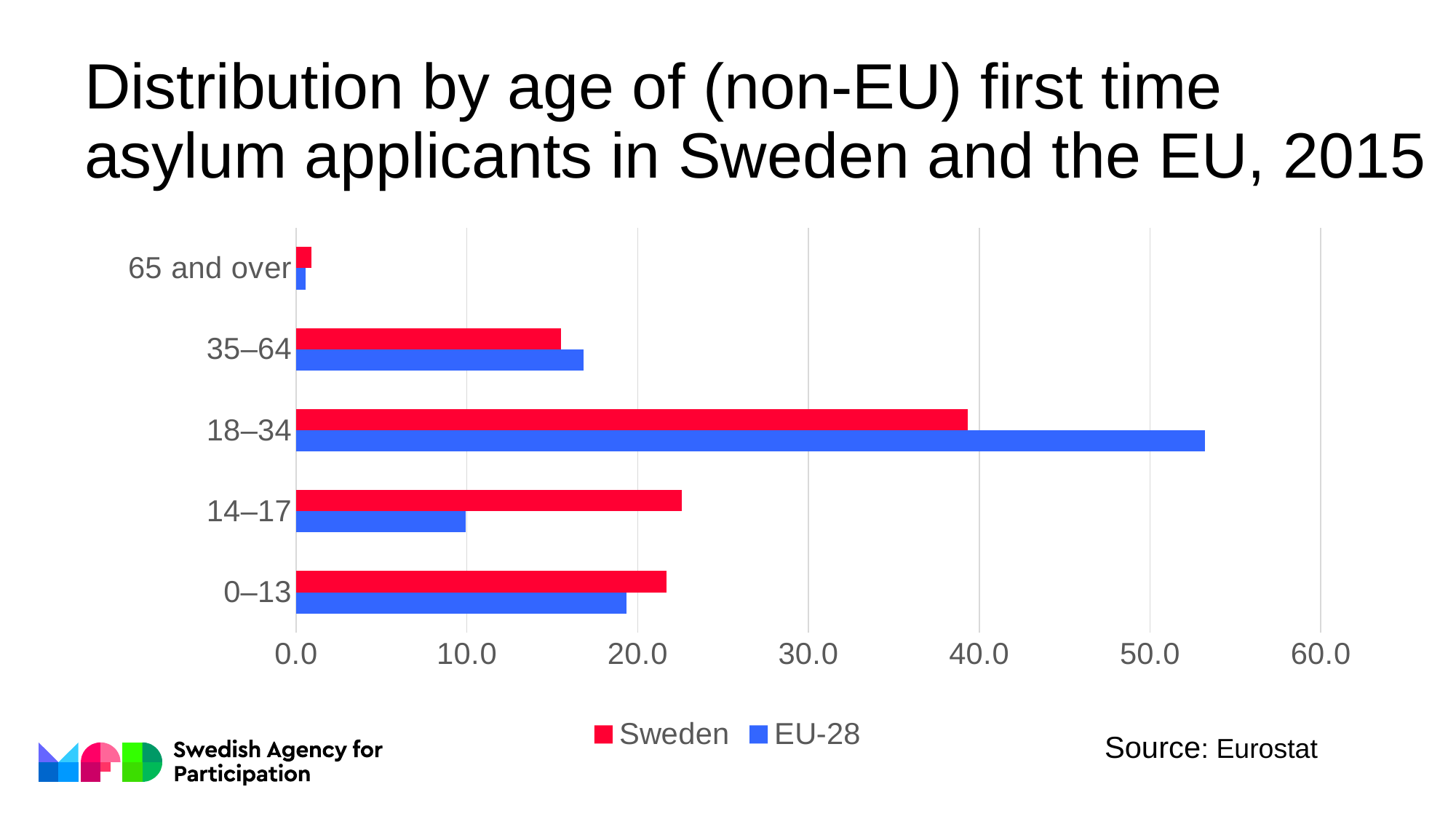
Which age group has the highest value for Sweden? 18–34 How many age groups are shown on the chart? 5 Which age group has the lowest value for EU-28? 65 and over What kind of chart is shown on the slide? bar chart How many series does the legend list? 2 For the 18–34 age group, which is larger: Sweden or EU-28? EU-28 Is the EU-28 value for the 14–17 age group greater or less than 20.0? less Which age group has the highest value for EU-28? 18–34 Which colour represents Sweden in the chart? red Is the EU-28 value for the 18–34 age group greater or less than 50.0? greater Is the Sweden value for the 0–13 age group greater or less than 20.0? greater For the 14–17 age group, which is larger: Sweden or EU-28? Sweden